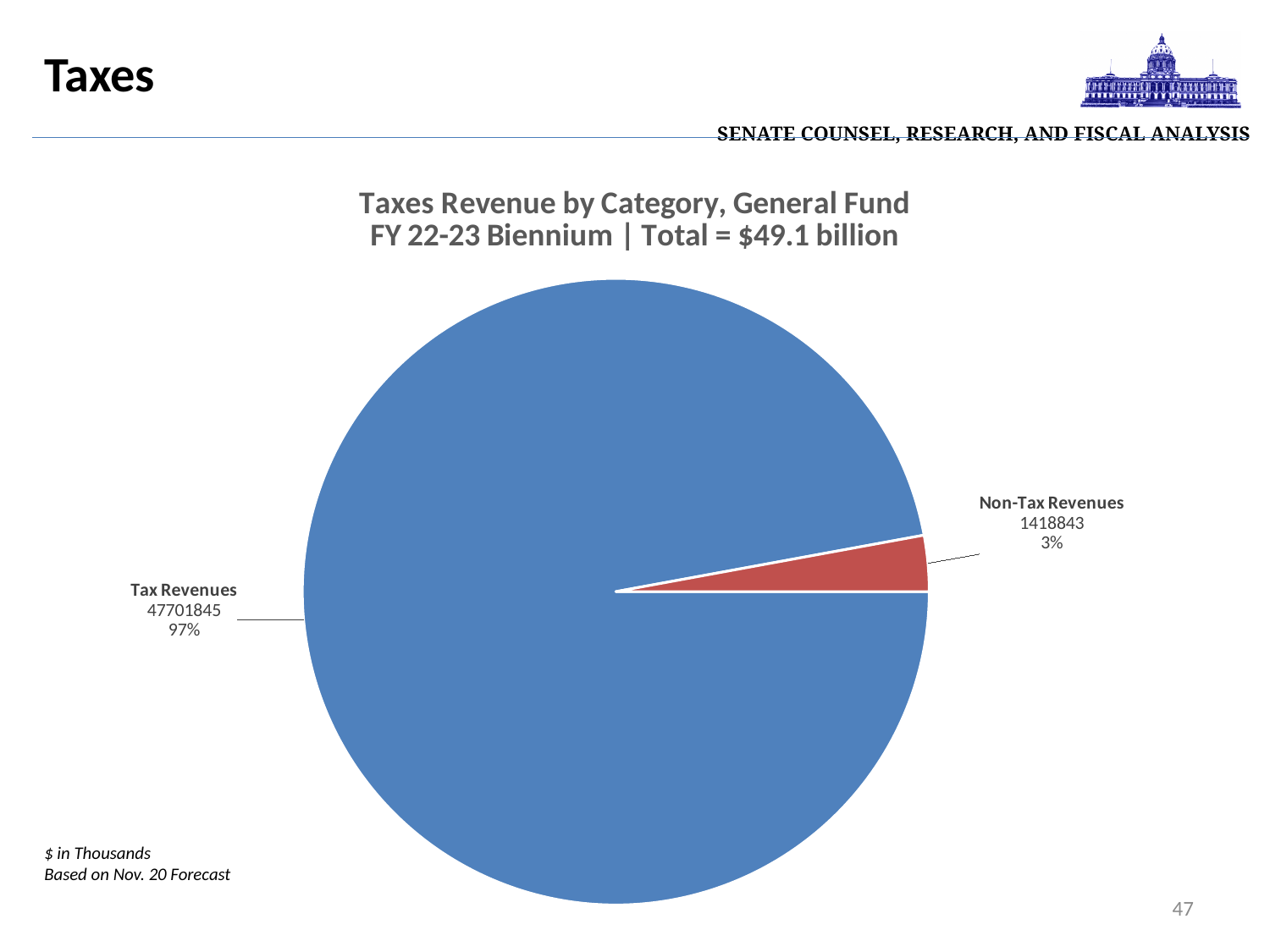
What is the value for Non-Tax Revenues? 1418843 Which category is the smallest slice of the pie? Non-Tax Revenues What is the title of the chart? Taxes Revenue by Category, General Fund FY 22-23 Biennium | Total = $49.1 billion What kind of chart is shown on the slide? pie chart What share of the pie does Non-Tax Revenues represent? 3% Which category is the largest slice of the pie? Tax Revenues What is the value for Tax Revenues? 47701845 What share of the pie does Tax Revenues represent? 97% Which is larger, Tax Revenues or Non-Tax Revenues? Tax Revenues What is the difference between the Tax Revenues value and the Non-Tax Revenues value? 46283002 How many categories are shown in the pie chart? 2 What colour is the Non-Tax Revenues slice? red